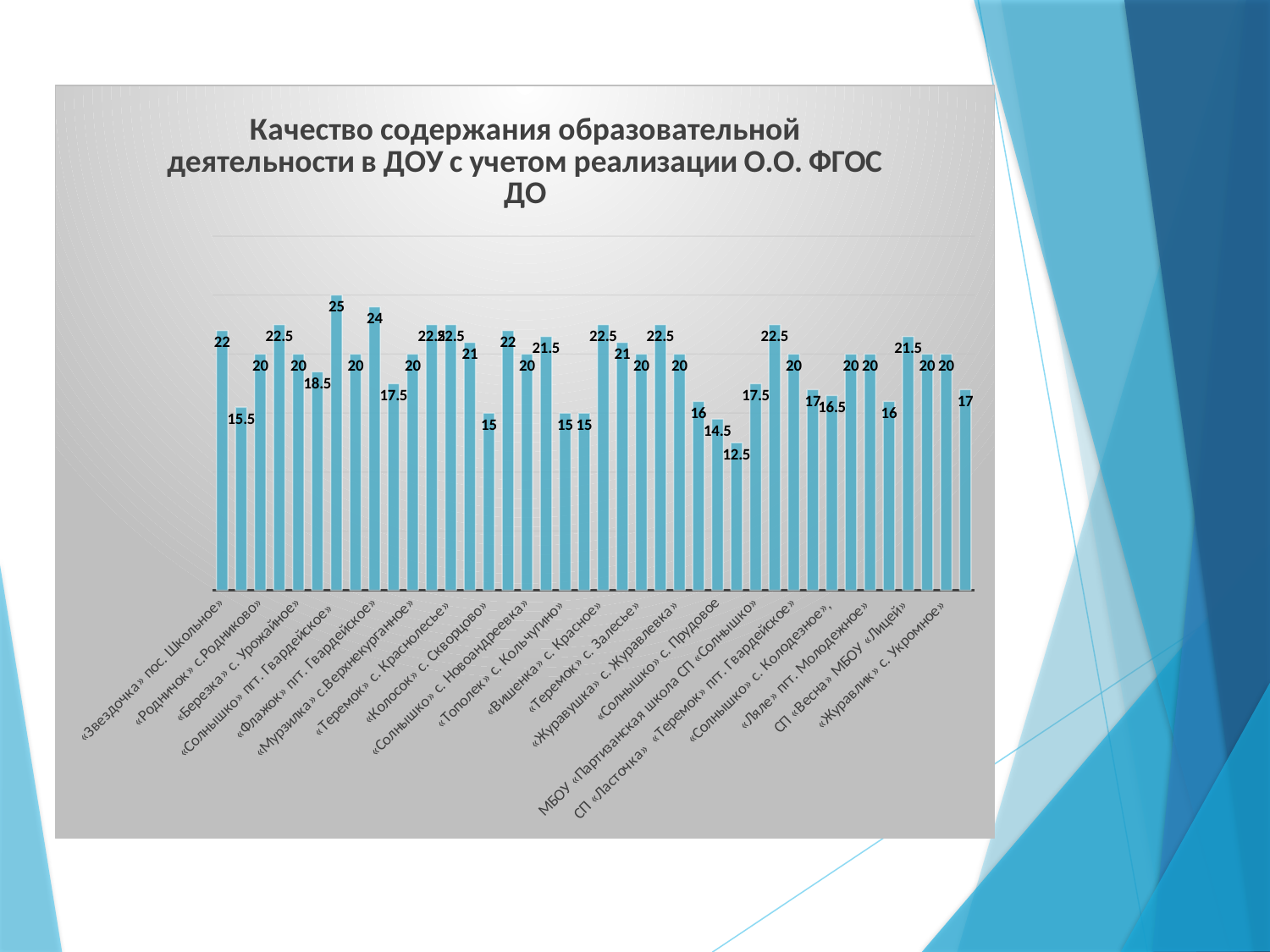
Which is larger, the first bar (22) or the second bar (15.5)? the first bar (22) What colour are the bars on the chart? light blue What is the title of the chart? Качество содержания образовательной деятельности в ДОУ с учетом реализации О.О. ФГОС ДО How many bars are plotted on the chart? 40 What kind of chart is shown on the slide? bar chart How many bars on the chart have the value 25? 1 What is the lowest value shown on the chart? 12.5 What is the difference between the highest value (25) and the lowest value (12.5) on the chart? 12.5 What is the value of the last bar on the chart? 17 What is the value of the first bar, labelled «Звездочка» пос. Школьное? 22 What is the highest value shown on the chart? 25 What is the value of the second bar on the chart? 15.5